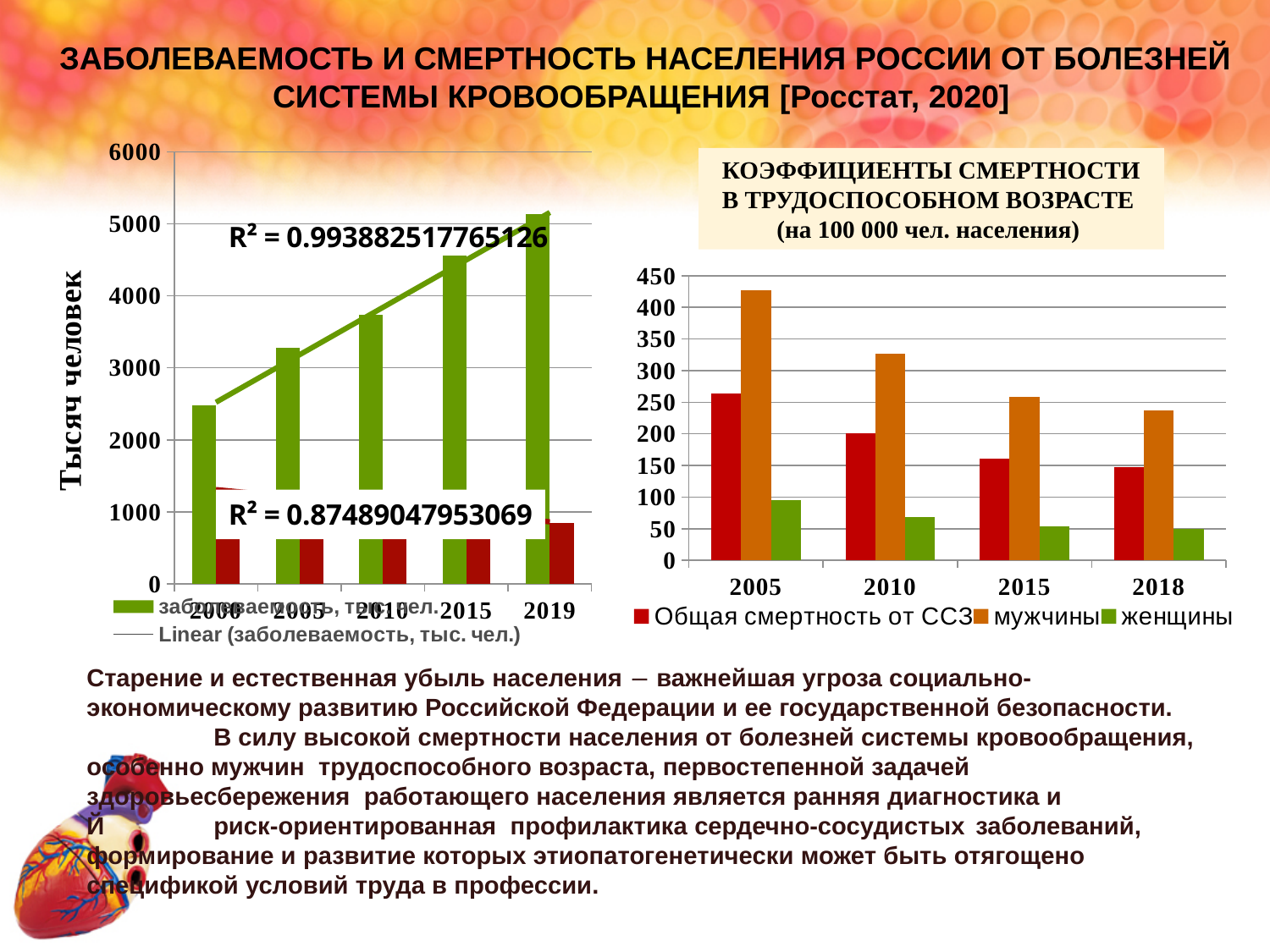
In the left chart (with y axis 'Тысяч человек'), what R² value is printed for the upper trend line? R² = 0.993882517765126 In the right chart (КОЭФФИЦИЕНТЫ СМЕРТНОСТИ В ТРУДОСПОСОБНОМ ВОЗРАСТЕ), which is larger in 2018: мужчины or женщины? мужчины In the right chart (КОЭФФИЦИЕНТЫ СМЕРТНОСТИ В ТРУДОСПОСОБНОМ ВОЗРАСТЕ), do the values for мужчины rise or fall from 2005 to 2018? fall In the left chart (with y axis 'Тысяч человек'), do the green bars for заболеваемость rise or fall from 2000 to 2019? rise In the left chart (with y axis 'Тысяч человек'), is the value for заболеваемость in 2019 greater or less than 5000? greater In the right chart (КОЭФФИЦИЕНТЫ СМЕРТНОСТИ В ТРУДОСПОСОБНОМ ВОЗРАСТЕ), how many years are shown on the x axis? 4 What kind of chart is the chart on the right, titled 'КОЭФФИЦИЕНТЫ СМЕРТНОСТИ В ТРУДОСПОСОБНОМ ВОЗРАСТЕ'? bar chart In the left chart (with y axis 'Тысяч человек'), how many years are shown on the x axis? 5 In the right chart (КОЭФФИЦИЕНТЫ СМЕРТНОСТИ В ТРУДОСПОСОБНОМ ВОЗРАСТЕ), is the value for женщины in 2010 greater or less than 100? less In the right chart (КОЭФФИЦИЕНТЫ СМЕРТНОСТИ В ТРУДОСПОСОБНОМ ВОЗРАСТЕ), how many series does the legend list? 3 In the right chart (КОЭФФИЦИЕНТЫ СМЕРТНОСТИ В ТРУДОСПОСОБНОМ ВОЗРАСТЕ), is the value for мужчины in 2005 greater or less than 400? greater In the right chart (КОЭФФИЦИЕНТЫ СМЕРТНОСТИ В ТРУДОСПОСОБНОМ ВОЗРАСТЕ), in which year is the value for мужчины highest? 2005